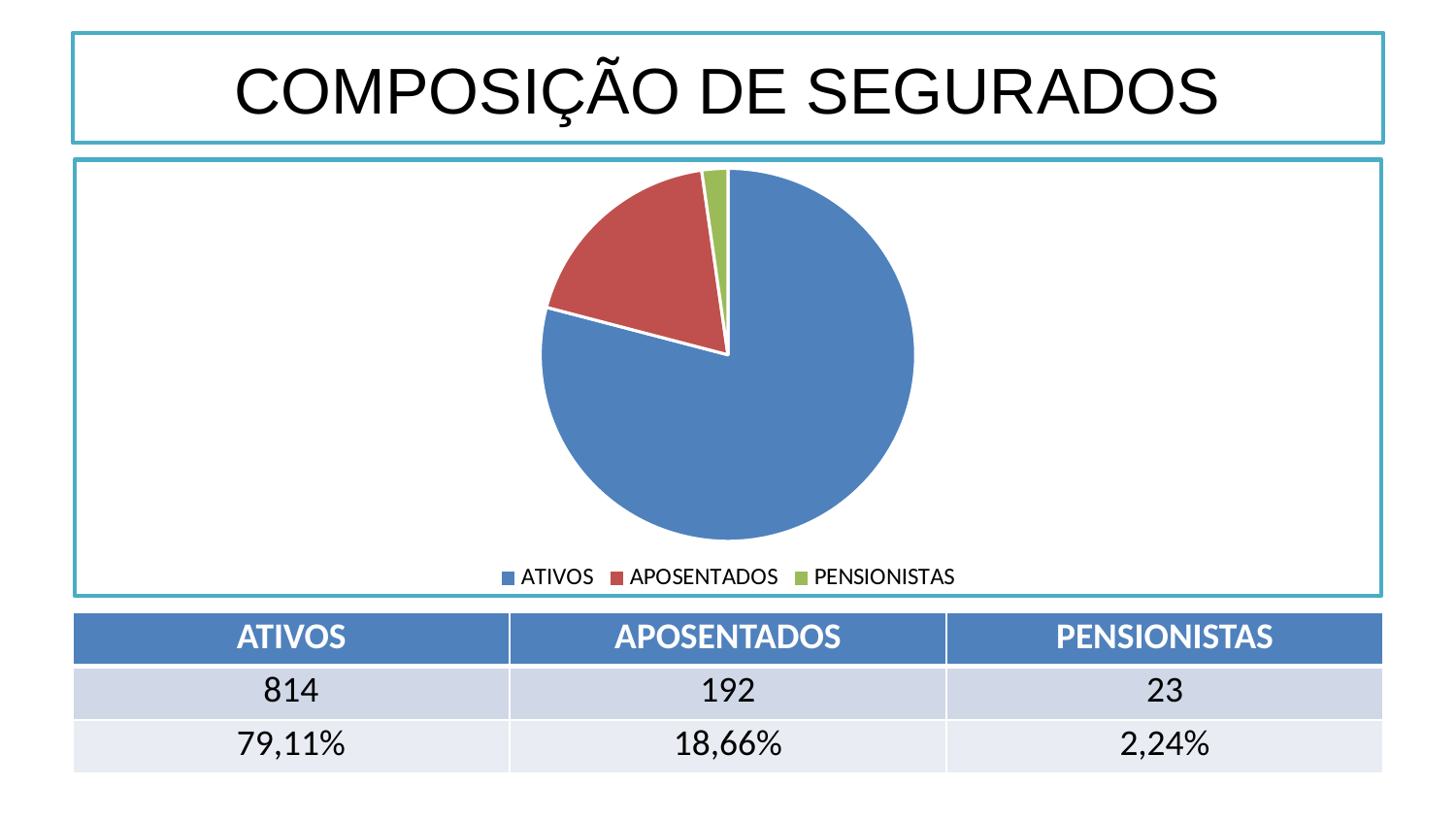
What share of the pie does PENSIONISTAS represent, according to the table? 2,24% What colour is the ATIVOS slice in the pie chart? blue How many slices does the pie chart have? 3 Which category has the largest slice of the pie chart? ATIVOS What is the value for PENSIONISTAS shown in the table below the chart? 23 What share of the pie does APOSENTADOS represent, according to the table? 18,66% Which category has the smallest slice of the pie chart? PENSIONISTAS What is the value for ATIVOS shown in the table below the chart? 814 How many entries does the legend of the pie chart list? 3 What kind of chart is shown on the slide? pie chart What is the value for APOSENTADOS shown in the table below the chart? 192 What is the difference between the values for ATIVOS and APOSENTADOS? 622